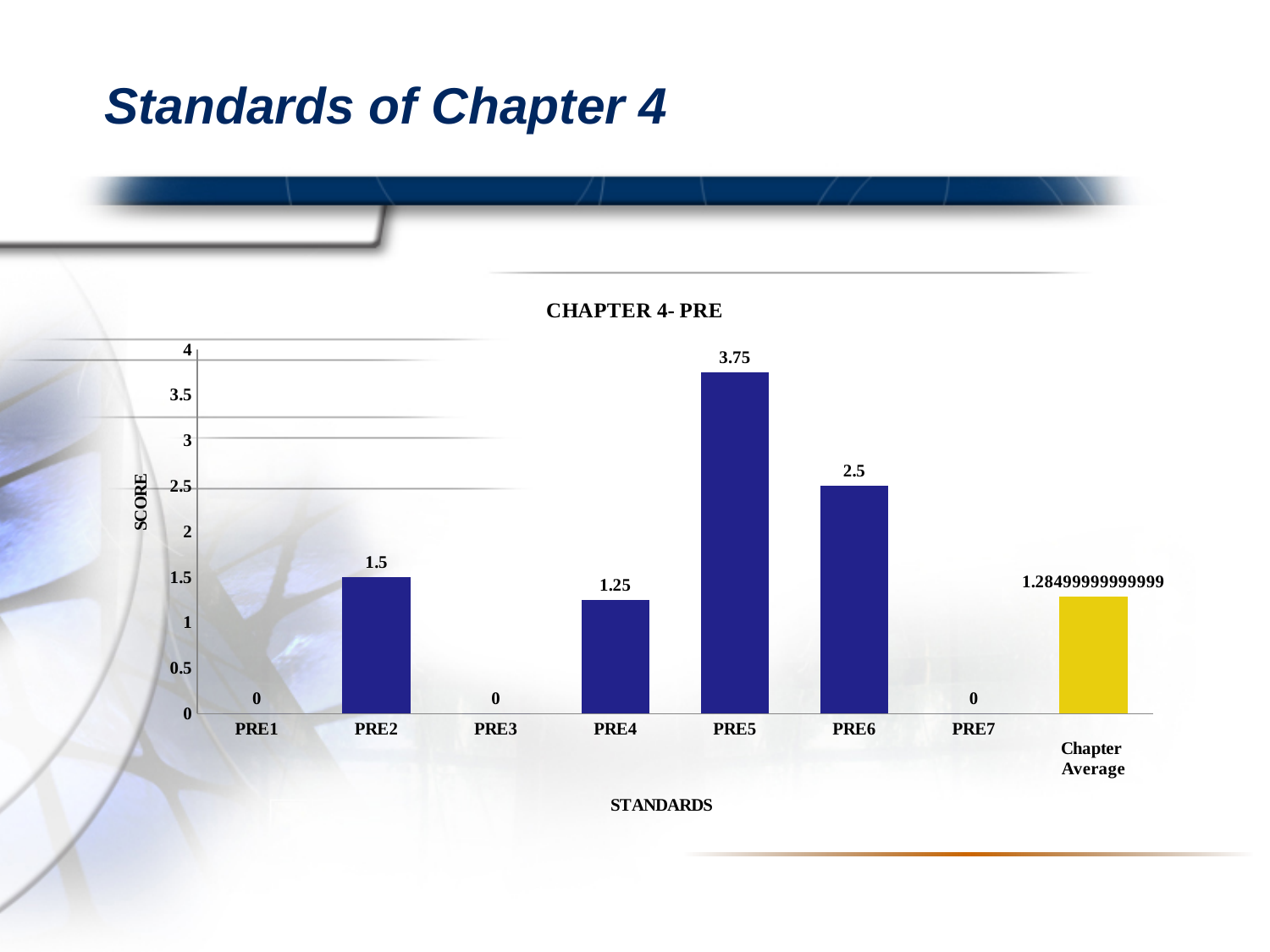
What is the value for PRE4? 1.25 Is the value for Chapter Average greater or less than 1? greater What is the value for PRE5? 3.75 How many categories are shown on the x axis? 8 Which is larger, the value for PRE6 or the value for PRE2? PRE6 What is the difference between the values for PRE5 and PRE6? 1.25 What is the title of the chart? CHAPTER 4- PRE What value is shown for Chapter Average? 1.28499999999999 Which standard has the highest score? PRE5 What kind of chart is shown? Bar chart What is the difference between the values for PRE2 and PRE4? 0.25 What is the value for PRE6? 2.5